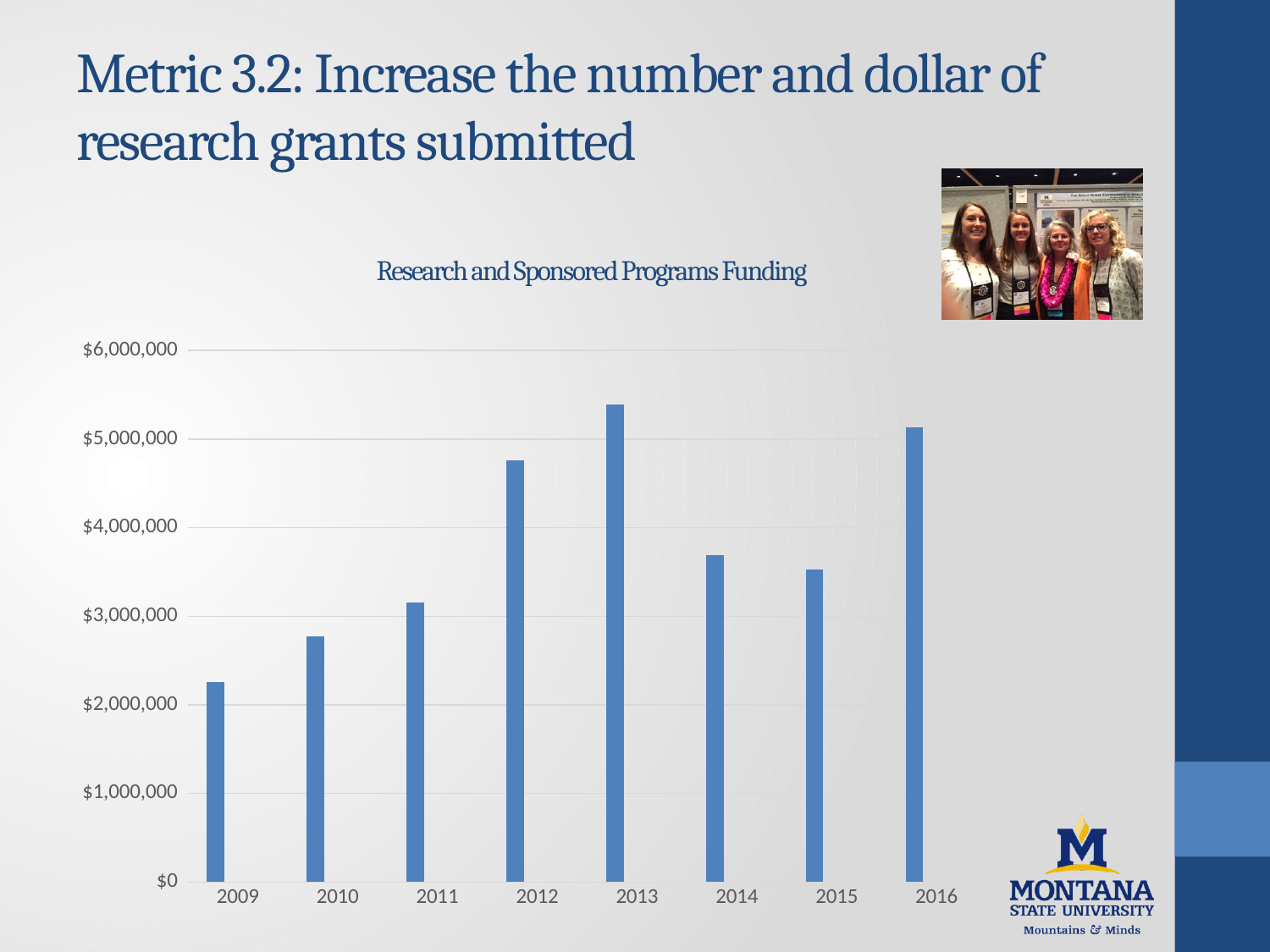
Is the funding value for 2015 greater or less than $4,000,000? less Is the funding value for 2013 greater or less than $5,000,000? greater Which year has the highest funding in the chart? 2013 Do the funding values rise or fall from 2009 to 2013? rise Is the funding value for 2012 greater or less than $4,000,000? greater Which year has higher funding, 2014 or 2016? 2016 How many years are shown on the x axis of the chart? 8 Which year has higher funding, 2010 or 2011? 2011 Which year has the lowest funding in the chart? 2009 What is the title of the chart? Research and Sponsored Programs Funding What kind of chart is shown on the slide? bar chart